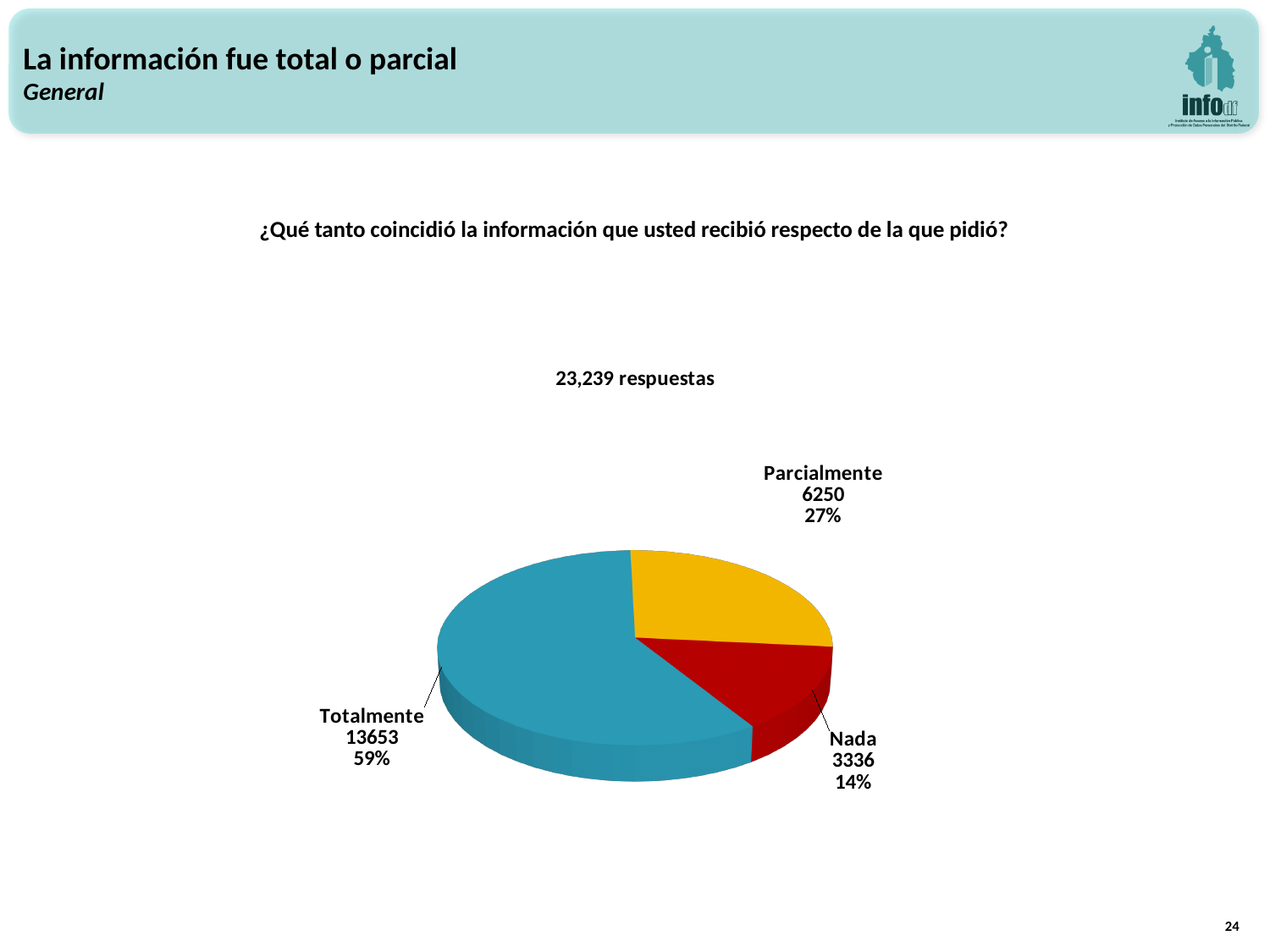
What share of the pie does Totalmente represent? 59% Which category has the largest slice? Totalmente What is the value for Nada? 3336 How many slices does the pie chart have? 3 What is the value for Totalmente? 13653 Which category has the smallest slice? Nada What kind of chart is shown on the slide? Pie chart What is the difference between the values for Parcialmente and Nada? 2914 What share of the pie does Nada represent? 14% Which is larger, Parcialmente or Nada? Parcialmente How many responses does the chart report in total? 23,239 respuestas What is the value for Parcialmente? 6250